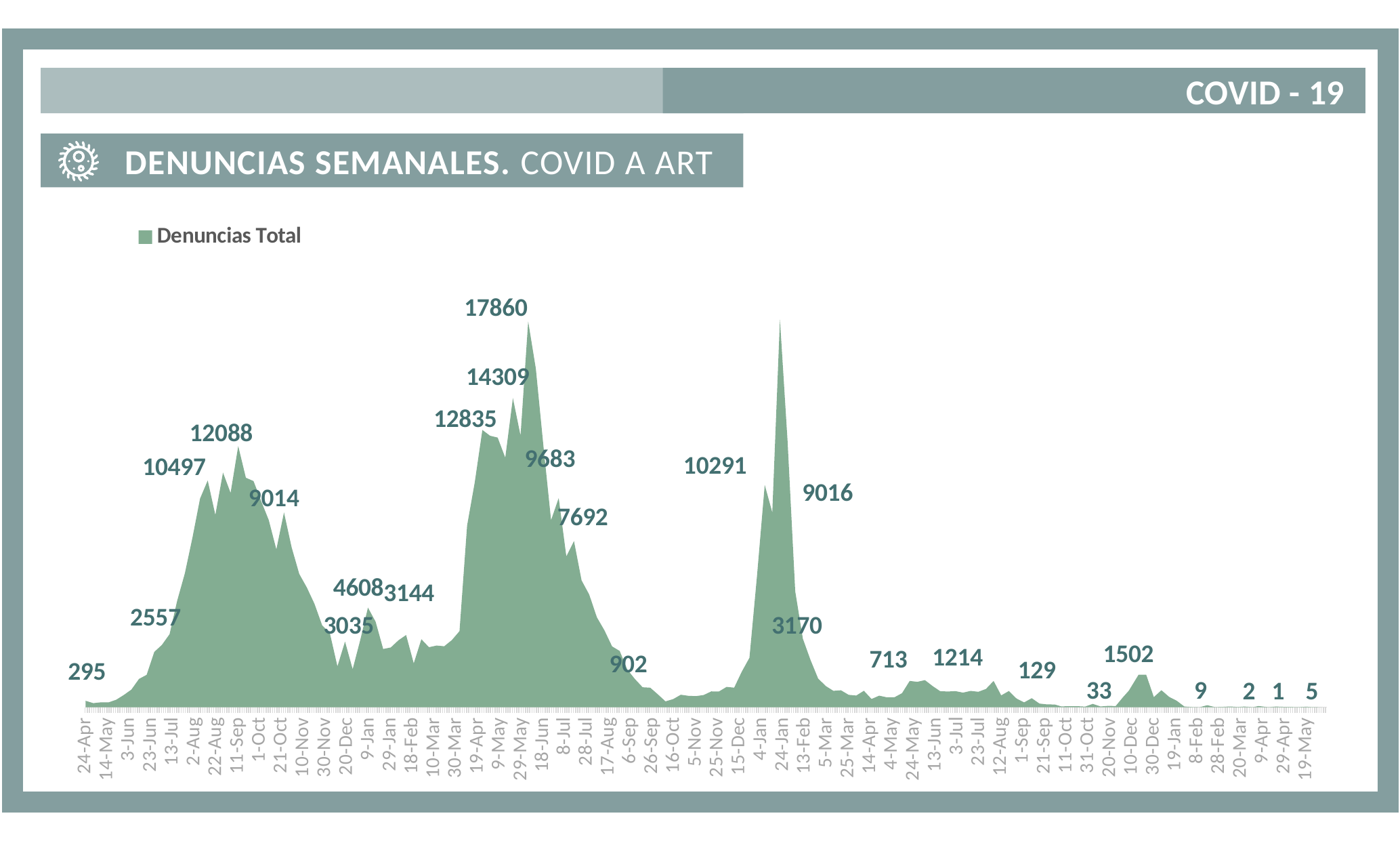
What is the difference between the highest labelled peak (17860) and the first peak labelled 12088? 5772 What is the value labelled at the first point of the series (24-Apr)? 295 What is the highest value labelled on the chart? 17860 What is the name of the series shown in the legend? Denuncias Total After the peak labelled 17860, do the values generally rise or fall towards the end of the x axis? fall How many series does the legend list? 1 What is the difference between the labelled values 1502 and 713? 789 What is the lowest value labelled on the chart? 1 What is the value labelled at the last point of the series (19-May)? 5 What is the title of the chart section on the slide? DENUNCIAS SEMANALES. COVID A ART What kind of chart is shown on the slide? area chart Which labelled peak is larger, 12088 or 10291? 12088